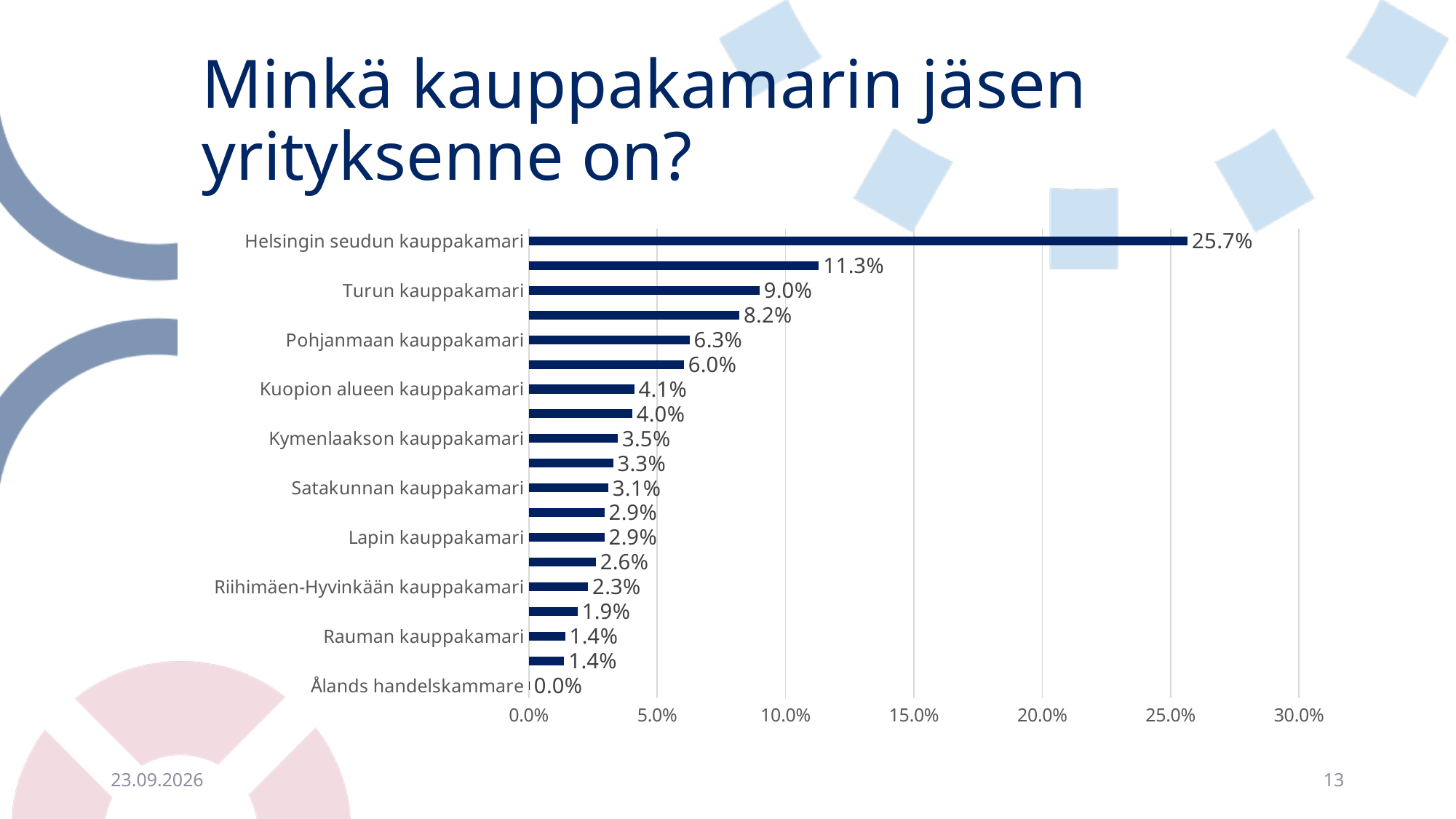
What is the difference between the values for Helsingin seudun kauppakamari and Turun kauppakamari? 16.7% What is the value for Ålands handelskammare? 0.0% How many bars are plotted in the chart? 19 What is the value for Pohjanmaan kauppakamari? 6.3% Which is larger, the value for Kymenlaakson kauppakamari or the value for Satakunnan kauppakamari? Kymenlaakson kauppakamari Which category has the lowest value? Ålands handelskammare What is the value for Helsingin seudun kauppakamari? 25.7% What is the value for Kuopion alueen kauppakamari? 4.1% What is the value for Riihimäen-Hyvinkään kauppakamari? 2.3% Which category has the highest value? Helsingin seudun kauppakamari What kind of chart is shown on the slide? Bar chart What is the value for Turun kauppakamari? 9.0%